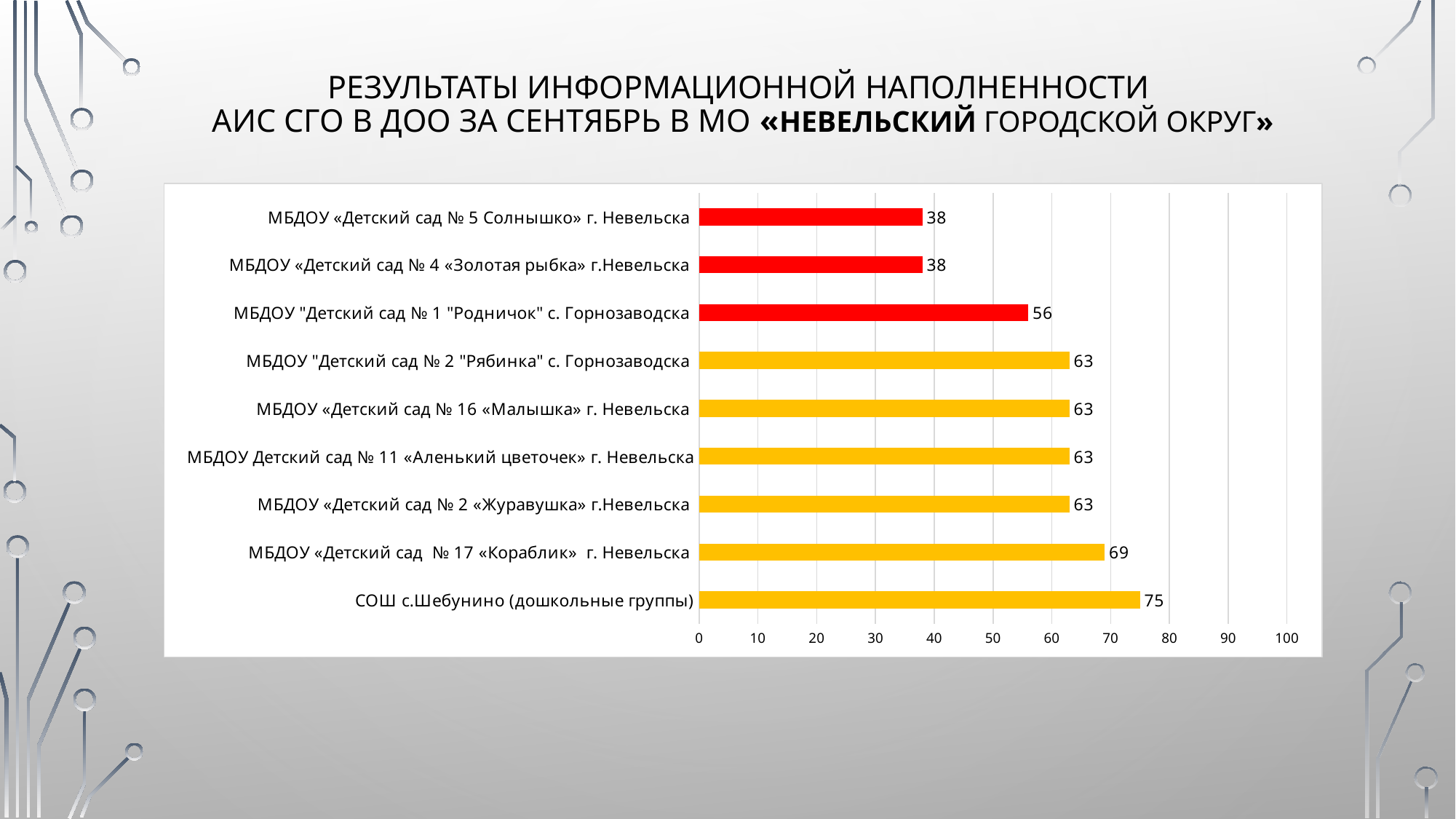
What value is shown for СОШ с.Шебунино (дошкольные группы)? 75 What kind of chart is shown on the slide? bar chart What value is shown for МБДОУ «Детский сад № 4 «Золотая рыбка» г.Невельска? 38 Which category has the highest value? СОШ с.Шебунино (дошкольные группы) How many categories are shown in the chart? 9 How many bars are coloured red? 3 What is the difference between the values for СОШ с.Шебунино (дошкольные группы) and МБДОУ «Детский сад № 5 Солнышко» г. Невельска? 37 Which is larger: the value for МБДОУ «Детский сад № 16 «Малышка» г. Невельска or the value for МБДОУ "Детский сад № 1 "Родничок" с. Горнозаводска? МБДОУ «Детский сад № 16 «Малышка» г. Невельска What value is shown for МБДОУ «Детский сад № 17 «Кораблик» г. Невельска? 69 Is the value for МБДОУ «Детский сад № 2 «Журавушка» г.Невельска greater or less than 50? greater What value is shown for МБДОУ "Детский сад № 1 "Родничок" с. Горнозаводска? 56 What is the difference between the values for МБДОУ «Детский сад № 17 «Кораблик» г. Невельска and МБДОУ "Детский сад № 1 "Родничок" с. Горнозаводска? 13